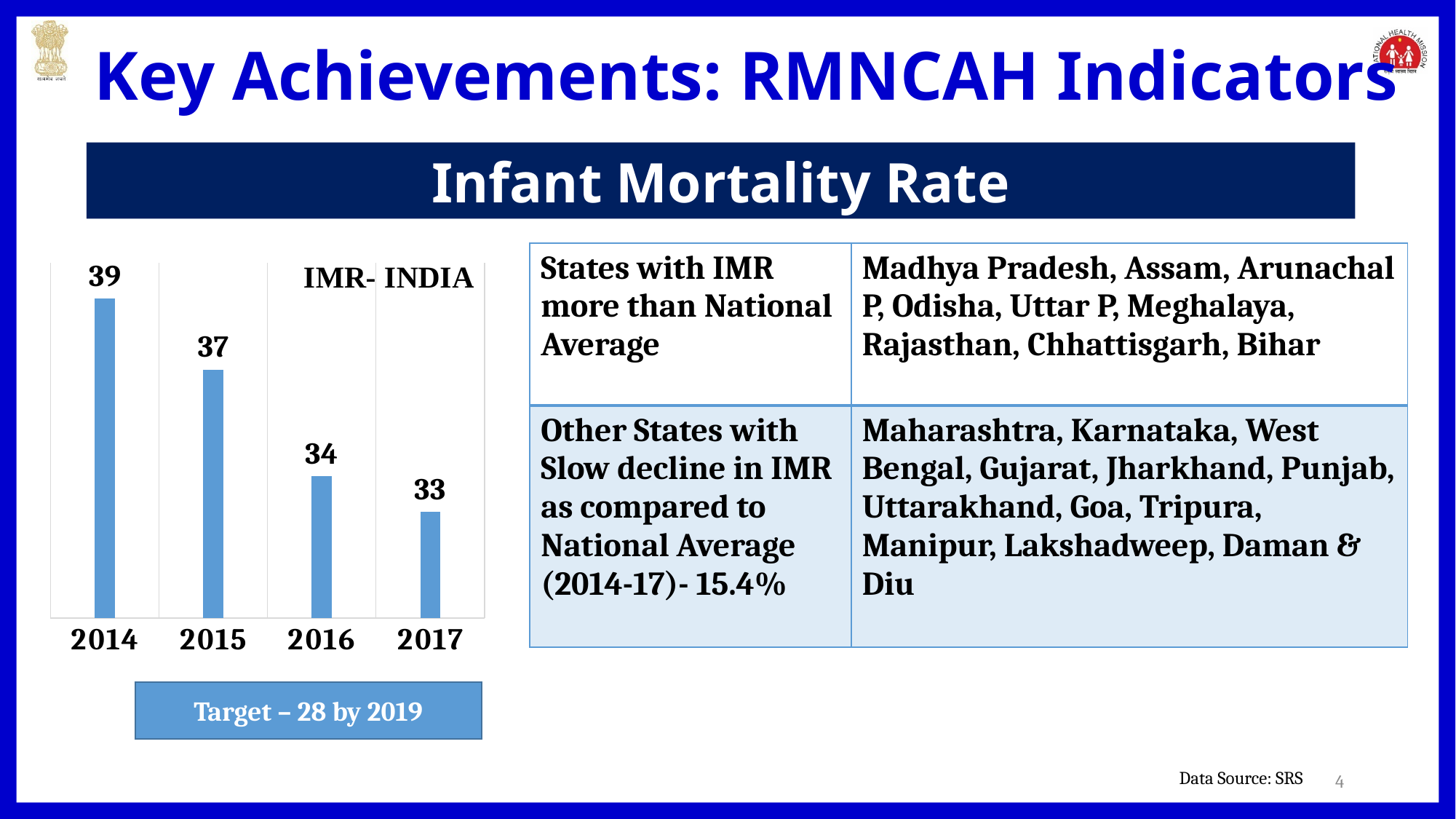
Which year has a higher IMR, 2015 or 2016? 2015 What is the IMR for India in 2017? 33 What is the IMR for India in 2014? 39 What is the title of the chart on the slide? IMR- INDIA Which year has the highest IMR in the chart? 2014 How many years are shown in the IMR chart? 4 Does the IMR rise or fall from 2014 to 2017? Fall Which year has the lowest IMR in the chart? 2017 What is the difference between the IMR in 2015 and 2016? 3 What type of chart is used to show IMR for India? Bar chart What is the IMR for India in 2016? 34 By how much did the IMR fall from 2014 to 2017? 6